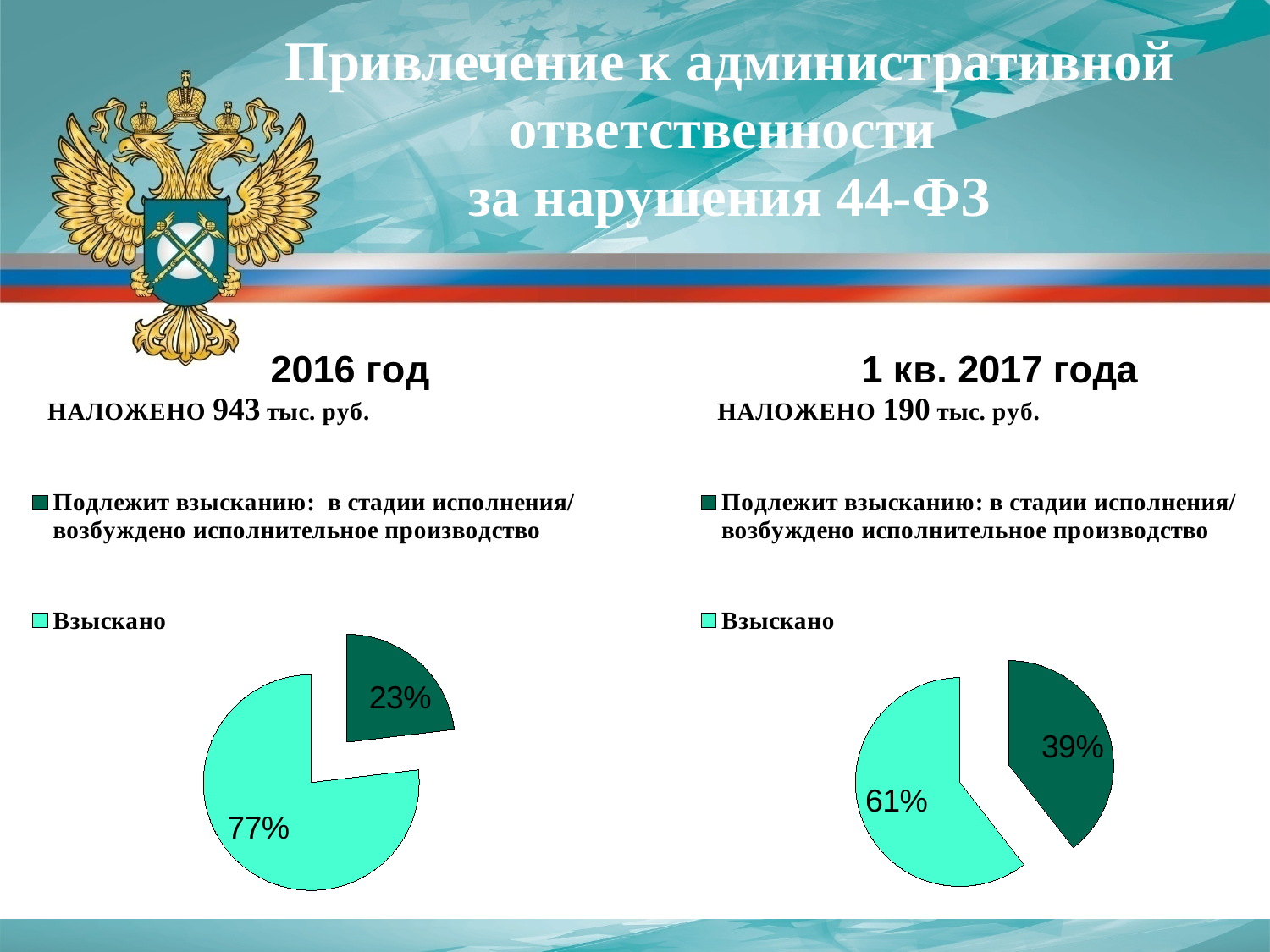
In the 2016 год chart, what is the difference between the Взыскано share and the Подлежит взысканию share? 54% How many slices does the 1 кв. 2017 года pie chart have? 2 In the 2016 год chart, what share of the pie is labelled Взыскано? 77% In the 1 кв. 2017 года chart, which slice is the smallest? Подлежит взысканию: в стадии исполнения/возбуждено исполнительное производство In the 2016 год chart, which slice is the largest? Взыскано What type of chart is shown for 1 кв. 2017 года? Pie chart In the 1 кв. 2017 года chart, what is the difference between the Взыскано share and the Подлежит взысканию share? 22% Which chart has the larger Взыскано share, 2016 год or 1 кв. 2017 года? 2016 год What type of chart is shown for 2016 год? Pie chart In the 1 кв. 2017 года chart, what share is labelled Подлежит взысканию: в стадии исполнения/возбуждено исполнительное производство? 39% In the 2016 год chart, what share is labelled Подлежит взысканию: в стадии исполнения/возбуждено исполнительное производство? 23%